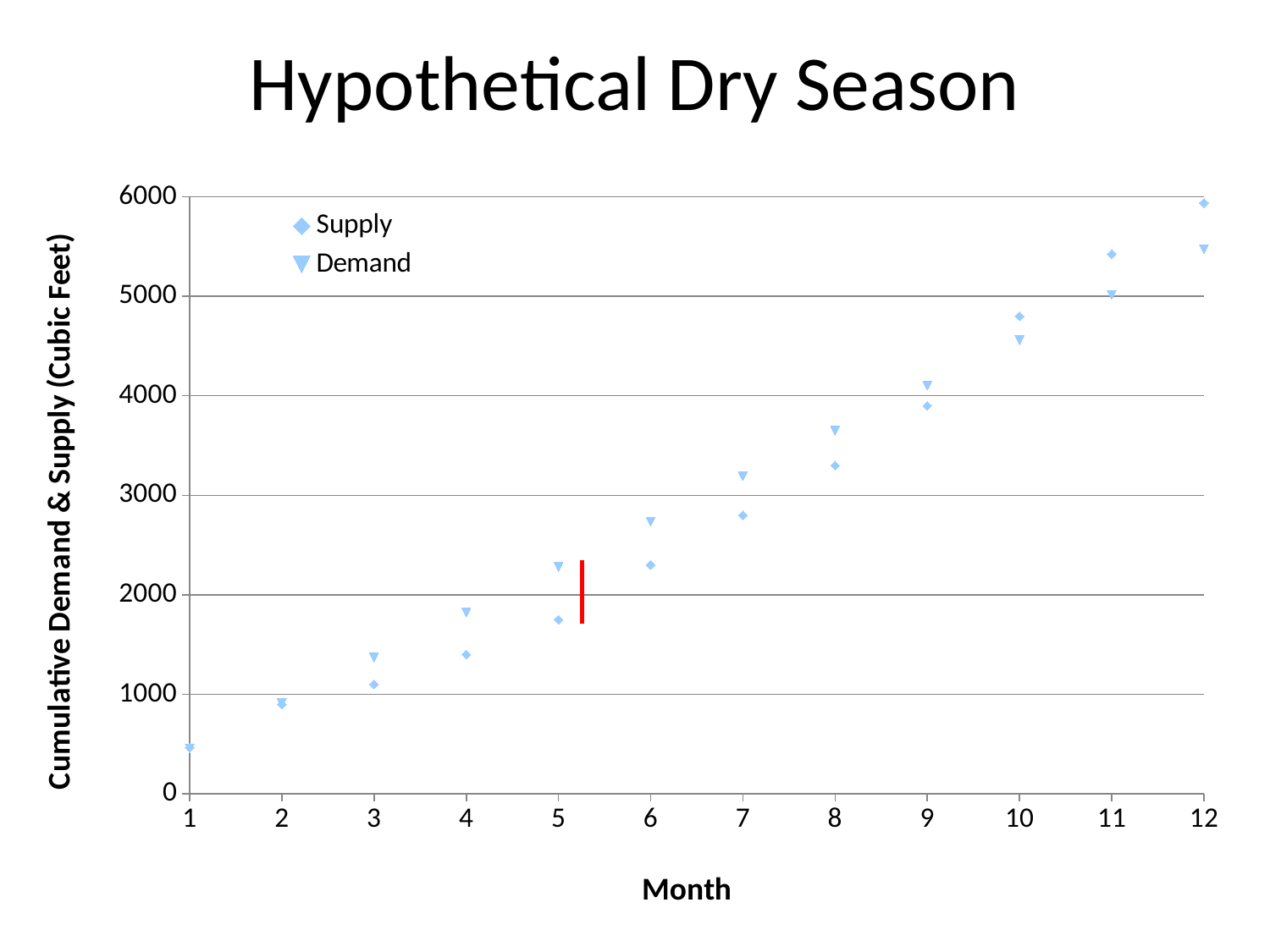
How many months are plotted along the x axis? 12 Is the Demand value at month 8 greater or less than 3000? greater Is the Supply value at month 5 greater or less than 2000? less At which month is the Supply value highest? 12 How many series does the legend list? 2 What kind of chart is shown on the slide? Scatter chart What is the title of the vertical axis? Cumulative Demand & Supply (Cubic Feet) Is the Demand value at month 6 greater or less than 3000? less At month 12, which is larger, Supply or Demand? Supply Do the Supply values rise or fall as the month increases? Rise At month 8, which is larger, Supply or Demand? Demand